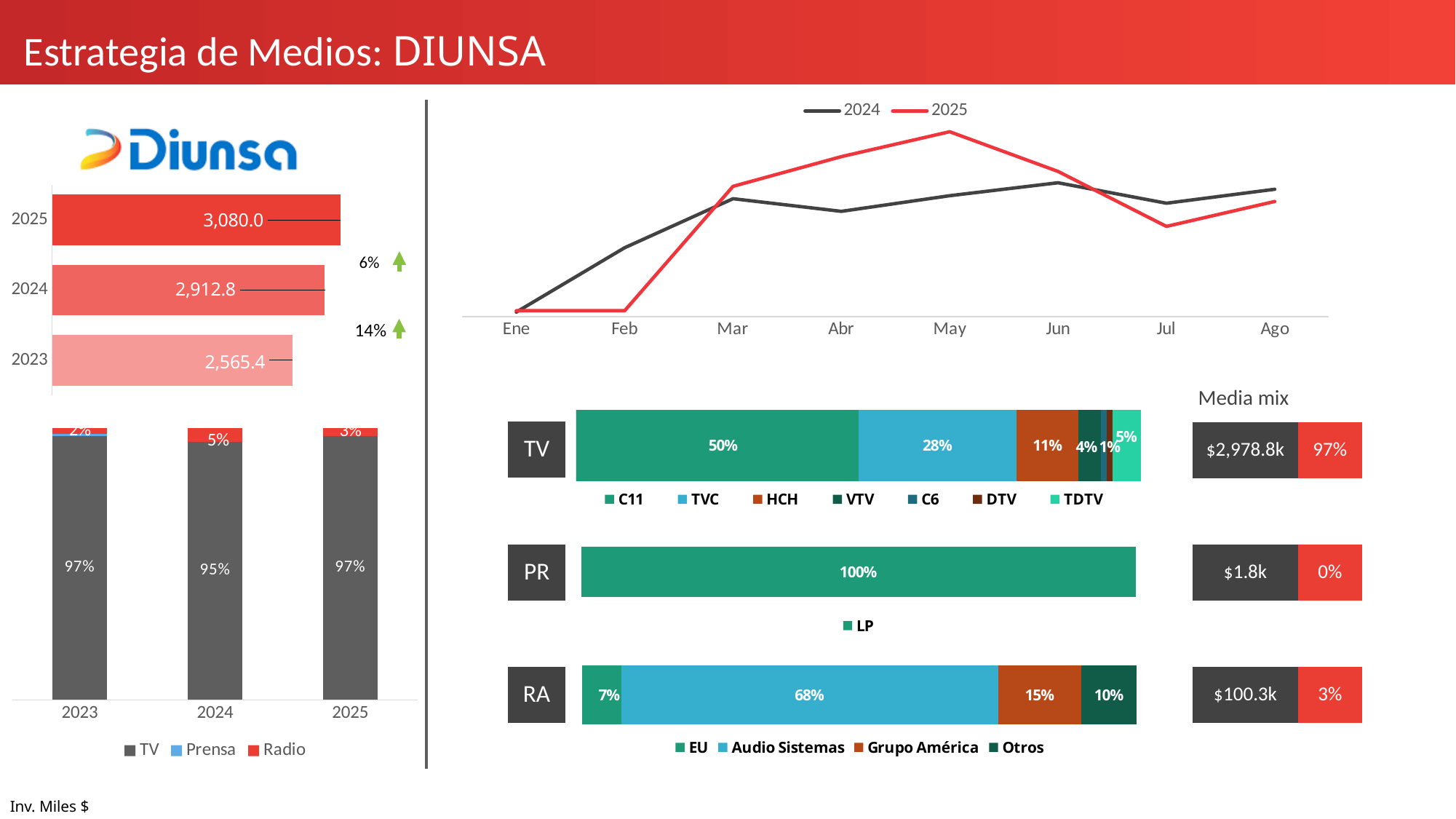
In the stacked bar chart of TV, Prensa and Radio by year at the bottom left, what is the TV share for 2024? 95% In the horizontal bar chart of yearly investment on the left, which year has the lowest value? 2023 In the Media mix table on the right, what is the amount shown for RA? $100.3k In the line chart at the top right comparing 2024 and 2025 by month, how many months are shown on the x axis? 8 In the horizontal bar chart of yearly investment on the left, what is the value for 2023? 2,565.4 In the horizontal bar chart of yearly investment on the left, what is the difference between the 2025 and 2024 values? 167.2 In the stacked bar chart of TV, Prensa and Radio by year at the bottom left, how many series does the legend list? 3 In the RA (radio) mix bar, which station has the largest share? Audio Sistemas In the horizontal bar chart of yearly investment on the left, what is the value for 2025? 3,080.0 In the TV channel mix bar, what is the share for TVC? 28% In the TV channel mix bar, how many channels does the legend list? 7 What kind of chart is the chart at the top right comparing 2024 and 2025 by month? Line chart